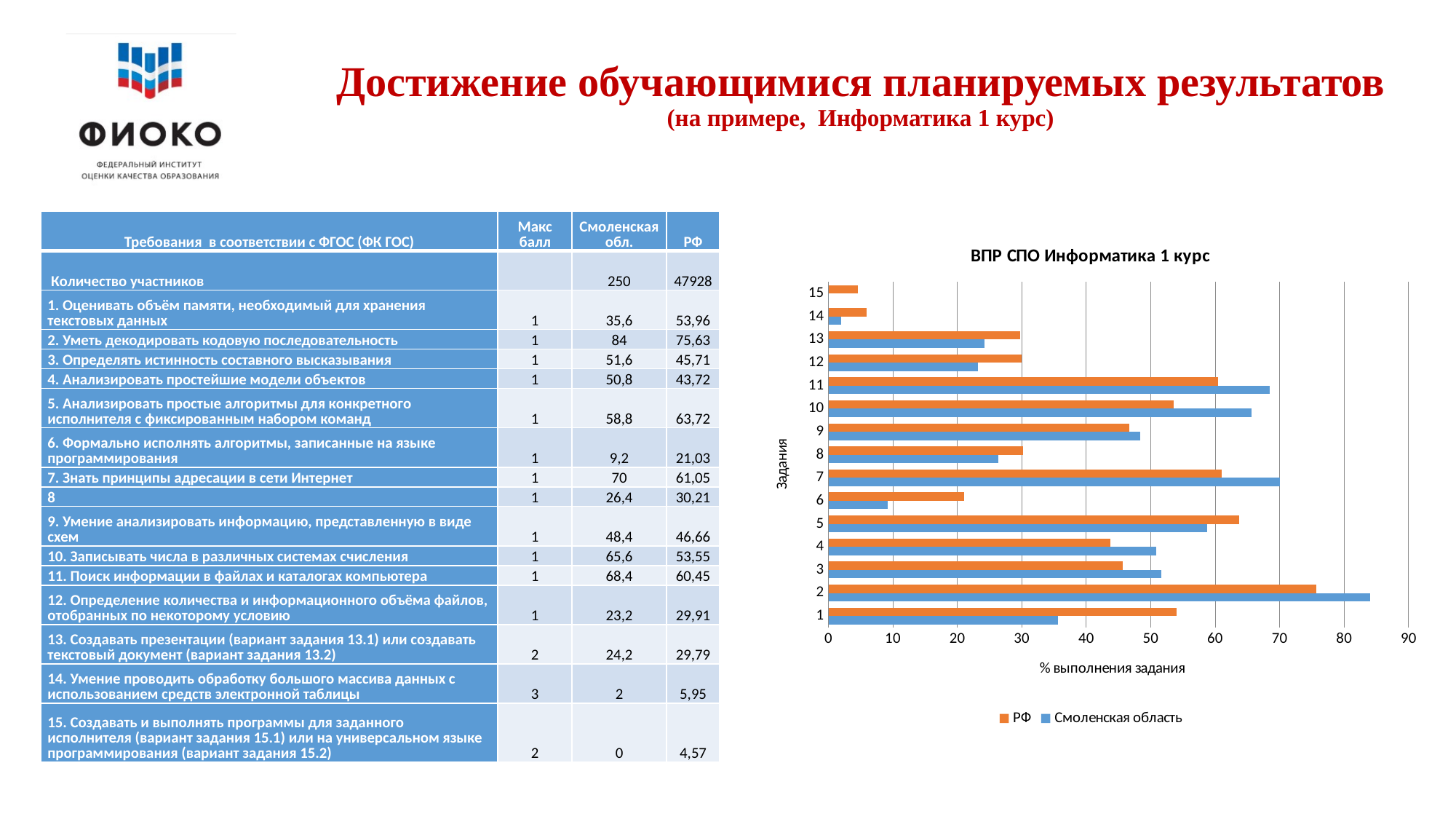
What kind of chart is shown on the slide? bar chart For task 11, which series has the larger value, РФ or Смоленская область? Смоленская область What is the title of the chart on the slide? ВПР СПО Информатика 1 курс How many series does the chart legend list? 2 Which task has the highest value for the Смоленская область series? 2 Is the Смоленская область value for task 14 greater or less than 10? less How many task categories are plotted on the chart's vertical axis? 15 For task 1, which series has the larger value, РФ or Смоленская область? РФ Which task has the lowest value for the РФ series? 15 Is the Смоленская область value for task 2 greater or less than 80? greater Is the РФ value for task 5 greater or less than 60? greater Which task has the highest value for the РФ series? 2